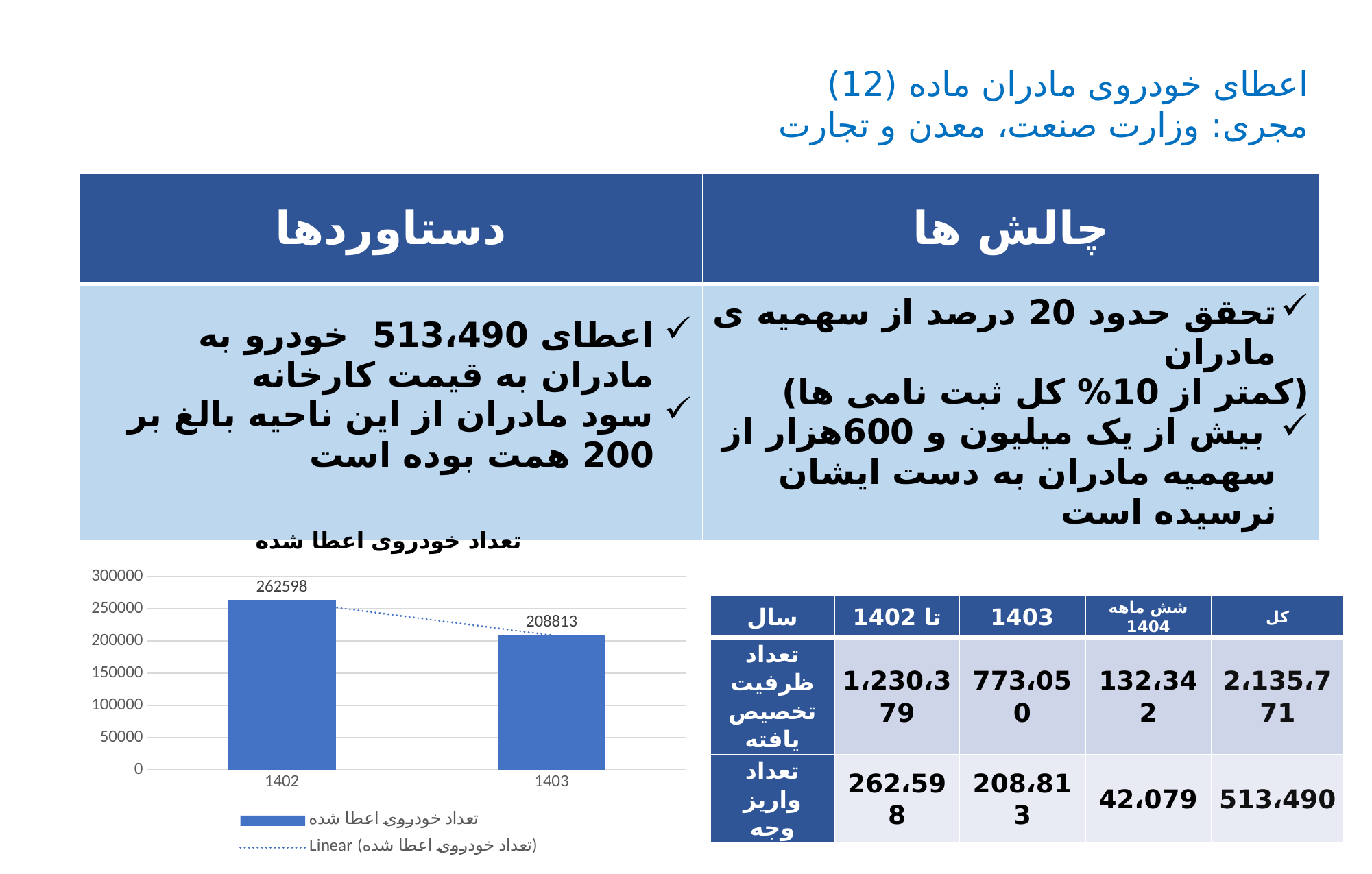
Is the value for 1402 greater or less than 250000? greater Is the value for 1402 larger or smaller than the value for 1403? larger What is the value for 1403 in the chart? 208813 Which year has the lower value in the chart? 1403 How many bars are plotted in the chart? 2 What is the value for 1402 in the chart? 262598 Do the values rise or fall from 1402 to 1403 in the chart? fall Which year has the higher value in the chart? 1402 How many entries does the chart legend list? 2 Is the value for 1403 greater or less than 250000? less What kind of chart is shown on the slide? bar chart What is the difference between the values for 1402 and 1403 in the chart? 53785